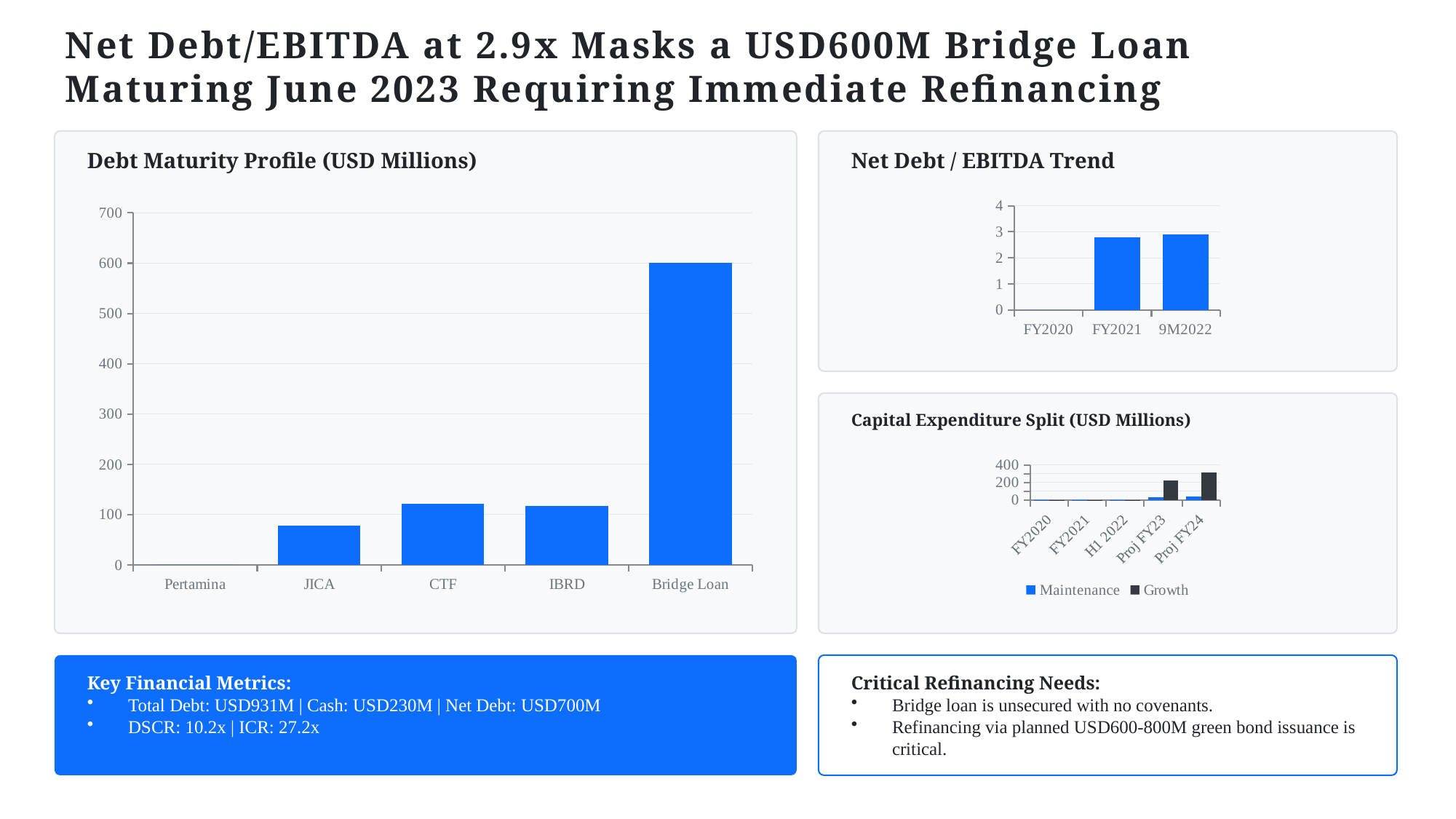
In the Capital Expenditure Split chart, is the Growth value for Proj FY24 greater or less than 200? greater In the Debt Maturity Profile chart, which category has the highest value? Bridge Loan In the Debt Maturity Profile chart, which is larger, the value for JICA or the value for CTF? CTF In the Net Debt / EBITDA Trend chart, which period has the lowest value? FY2020 In the Debt Maturity Profile chart, what kind of chart is shown? bar chart In the Debt Maturity Profile chart, how many categories are plotted on the x axis? 5 In the Net Debt / EBITDA Trend chart, is the value for FY2021 greater or less than 2? greater In the Net Debt / EBITDA Trend chart, how many periods are shown on the x axis? 3 In the Capital Expenditure Split chart, how many series does the legend list? 2 In the Debt Maturity Profile chart, is the value for JICA greater or less than 100? less In the Debt Maturity Profile chart, which category has the lowest value? Pertamina